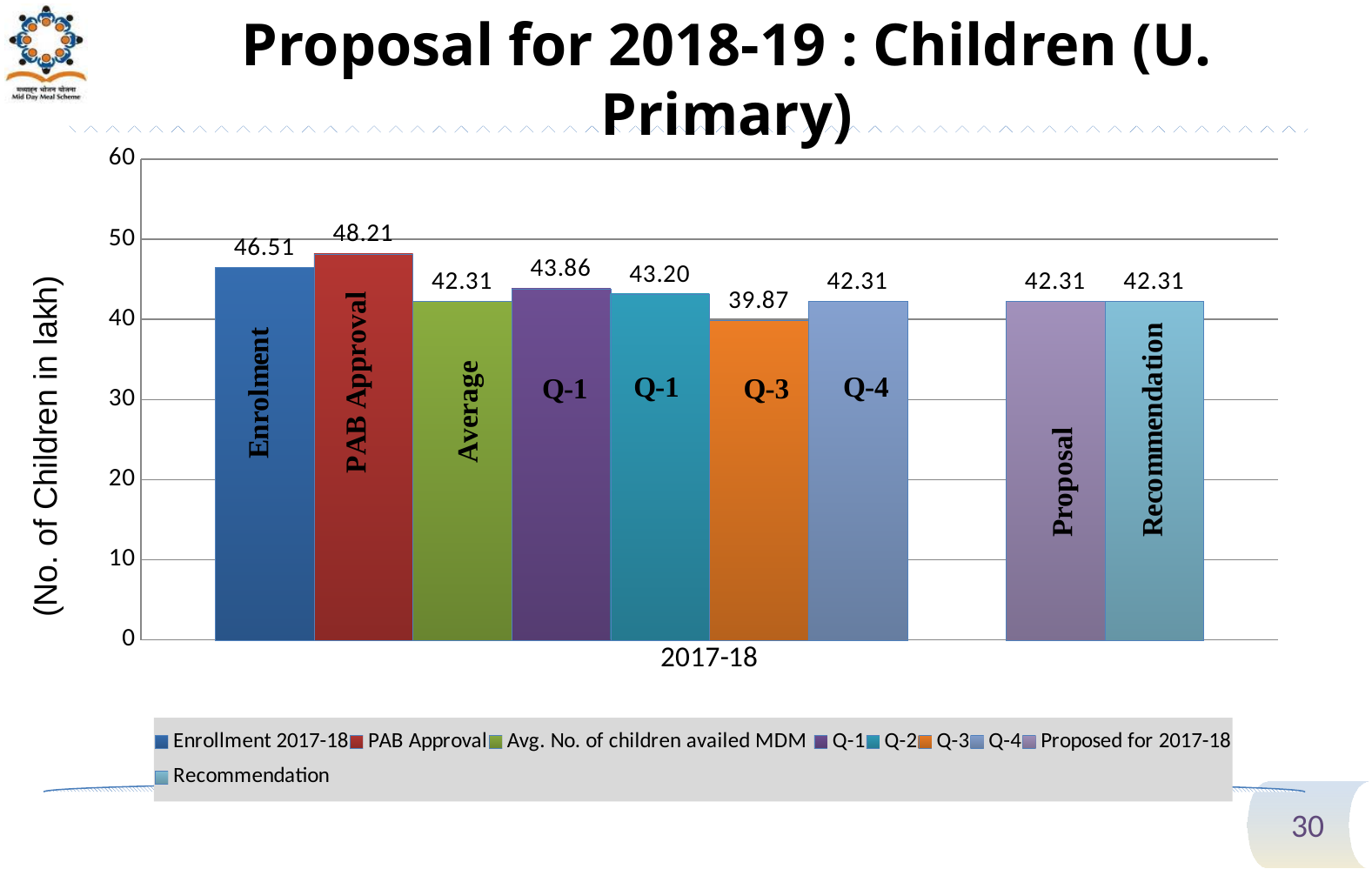
How many series does the legend list? 9 Which is larger, the Q-1 bar or the Q-3 bar? Q-1 What is the value of the Q-3 bar? 39.87 Is the value for Q-3 greater or less than 40? less What is the value of the Enrolment bar? 46.51 What is the value of the Recommendation bar? 42.31 What is the value of the PAB Approval bar? 48.21 What is the difference between the PAB Approval value and the Enrolment value? 1.70 Which bar has the lowest value? Q-3 Which bar has the highest value? PAB Approval What is the y-axis title of the chart? (No. of Children in lakh) What kind of chart is shown on the slide? Bar chart